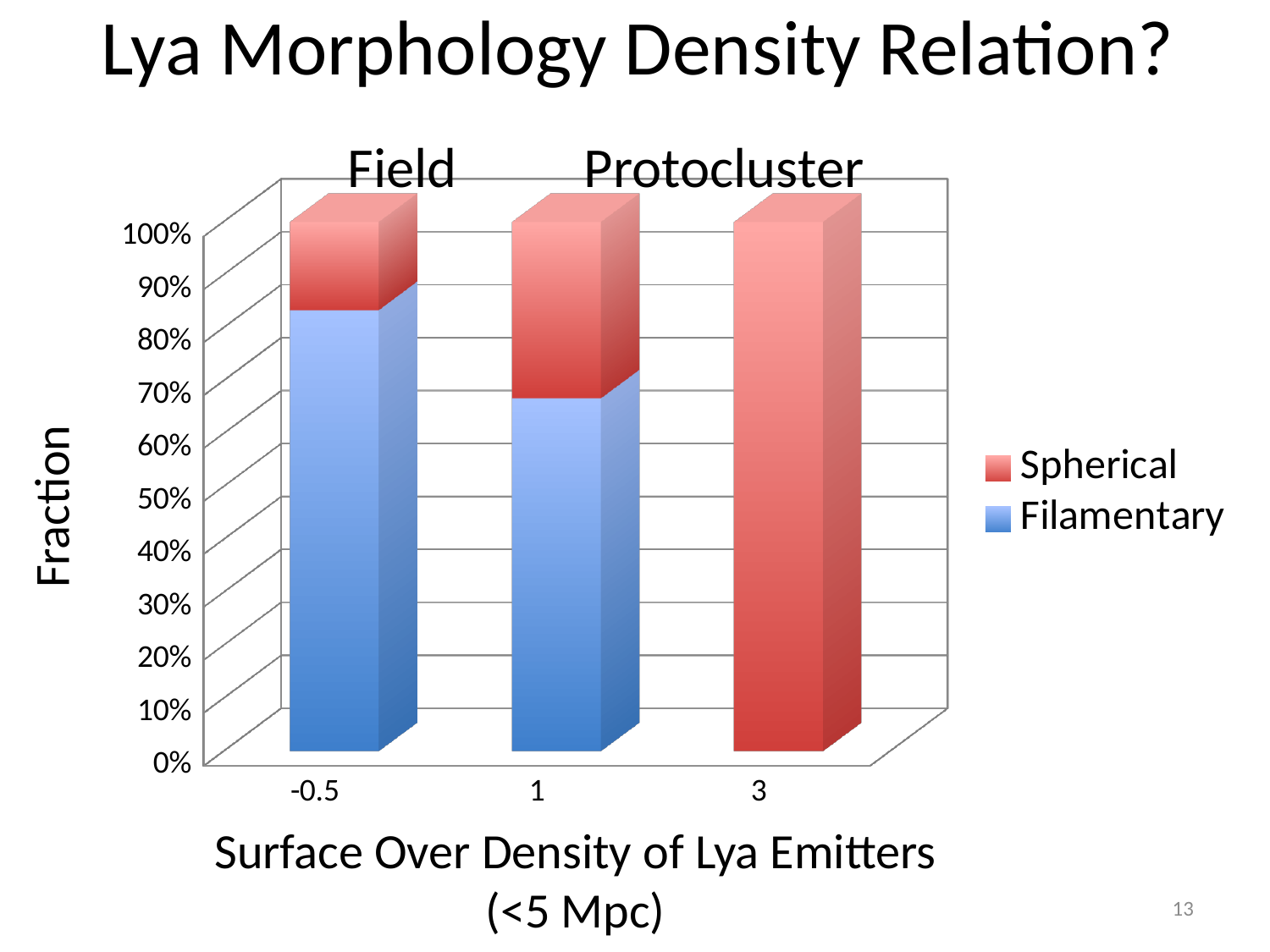
Which category has the lowest Filamentary fraction? 3 Does the Filamentary fraction rise or fall as the surface over density increases along the x axis? fall Which category has the highest Filamentary fraction? -0.5 Which category has the highest Spherical fraction? 3 Is the Filamentary value for -0.5 greater or less than 70%? greater What is the title of the x axis? Surface Over Density of Lya Emitters (<5 Mpc) Is the Spherical value for 3 greater or less than 90%? greater How many series does the legend list? 2 Is the Filamentary value for 1 greater or less than 80%? less Which is larger, the Filamentary fraction at -0.5 or the Filamentary fraction at 1? -0.5 What kind of chart is shown on the slide? stacked bar chart How many categories are shown on the x axis? 3